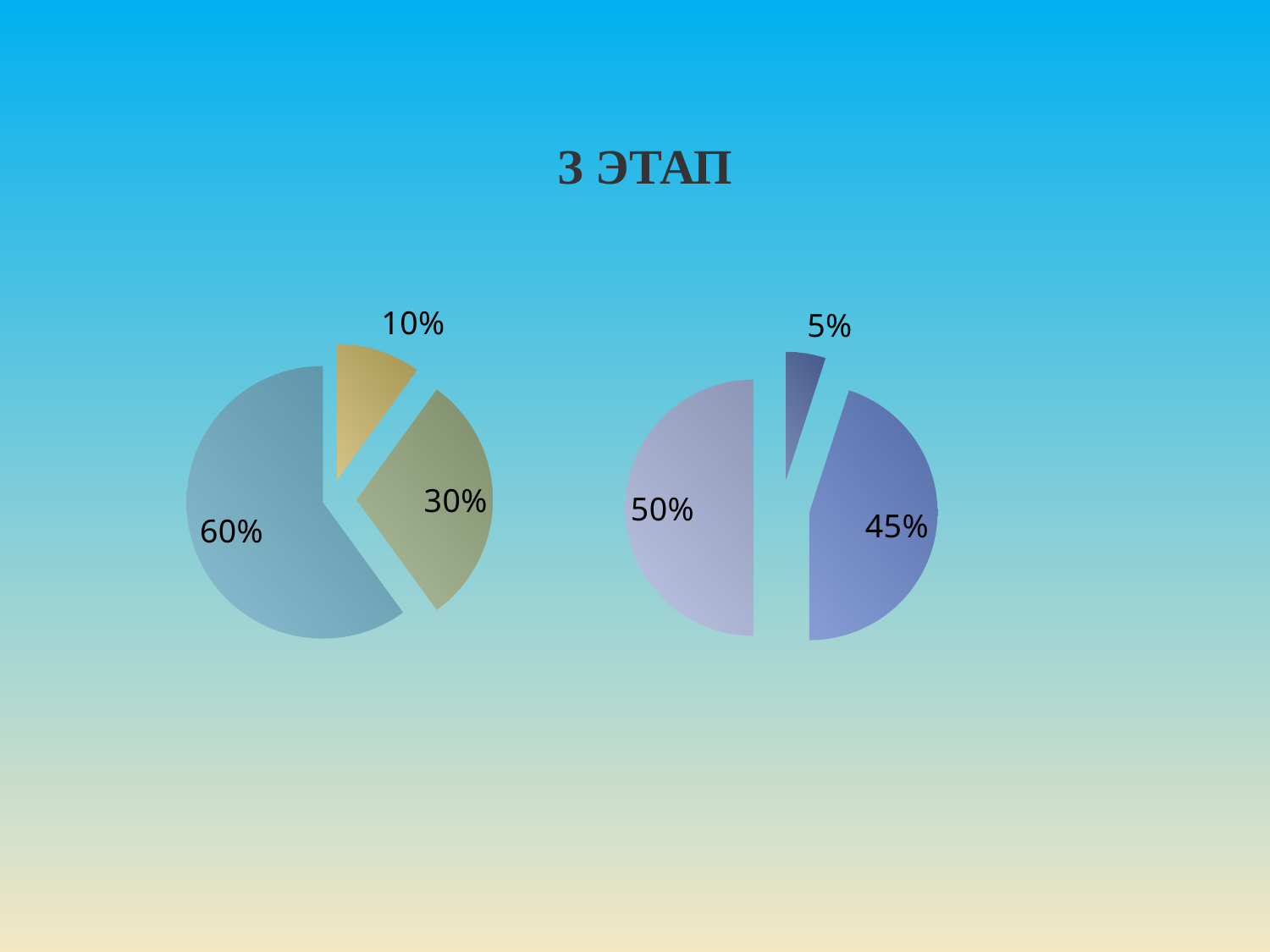
What kind of chart is the chart on the right of the slide? pie chart In the pie chart on the left, what value is shown on the yellow slice at the top? 10% What kind of chart is the chart on the left of the slide? pie chart In the pie chart on the right, what is the difference between the 50% slice and the 45% slice? 5% What is the title shown above the charts on the slide? 3 ЭТАП In the pie chart on the right, what is the smallest slice's value? 5% In the pie chart on the left, what is the difference between the largest slice and the smallest slice? 50% In the pie chart on the left, how many slices are there? 3 In the pie chart on the left, what is the largest slice's value? 60% In the pie chart on the right, how many slices are there? 3 In the pie chart on the right, what is the largest slice's value? 50% In the pie chart on the left, what is the smallest slice's value? 10%